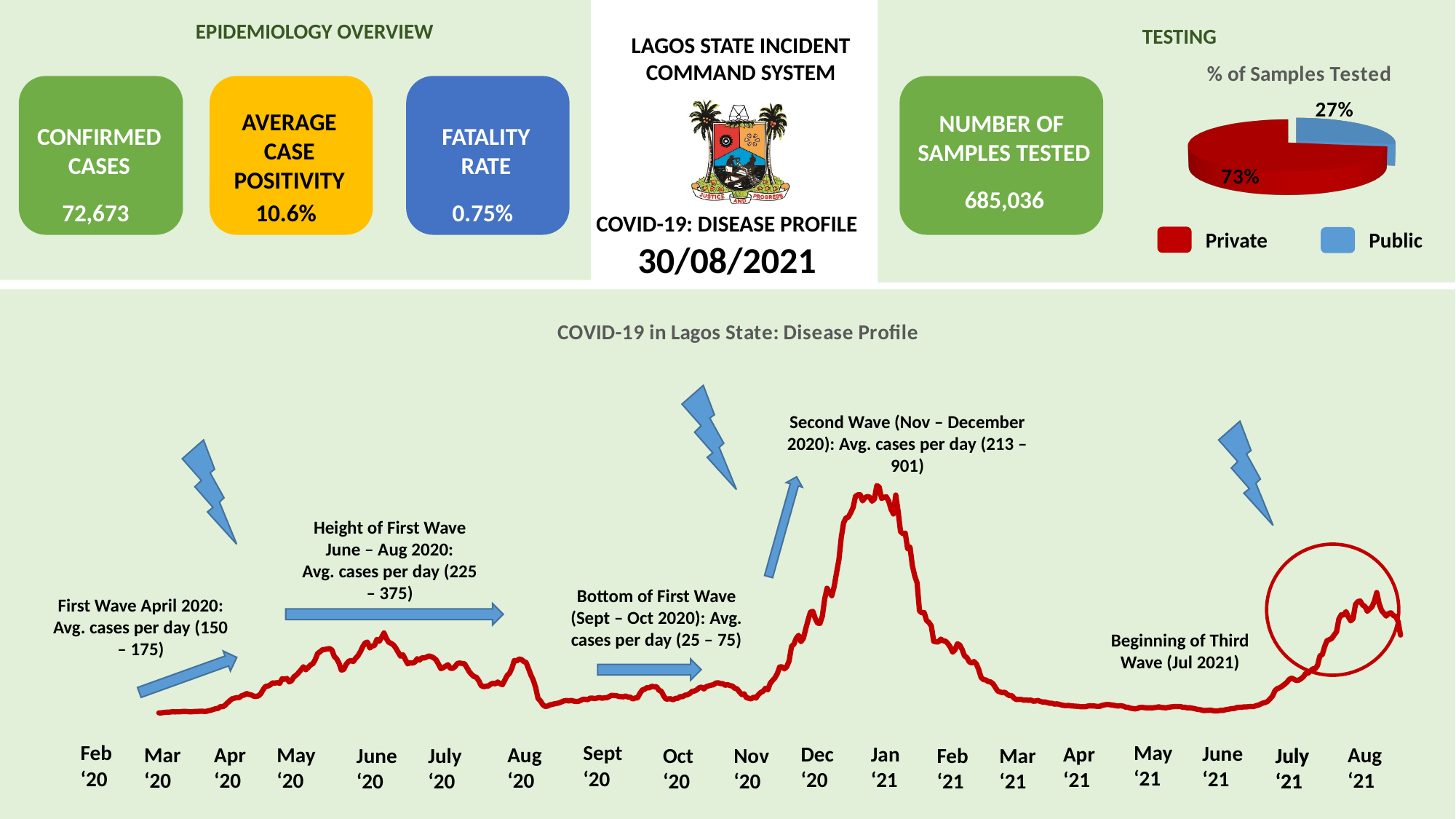
In the '% of Samples Tested' pie chart, what colour represents Public? Blue In the '% of Samples Tested' pie chart, what percentage of samples were tested by Private facilities? 73% In the 'COVID-19 in Lagos State: Disease Profile' chart, does the line rise or fall between Jan '21 and Mar '21? Fall What kind of chart is the '% of Samples Tested' chart? Pie chart In the '% of Samples Tested' pie chart, what percentage of samples were tested by Public facilities? 27% What kind of chart is 'COVID-19 in Lagos State: Disease Profile'? Line chart In the '% of Samples Tested' pie chart, which category has the larger share? Private In the '% of Samples Tested' pie chart, what is the difference in percentage points between the Private and Public shares? 46% In the 'COVID-19 in Lagos State: Disease Profile' chart, around which month label does the line reach its highest point? Jan '21 In the 'COVID-19 in Lagos State: Disease Profile' chart, what range of average cases per day is annotated for the Second Wave (Nov – December 2020)? 213 – 901 How many categories does the legend of the '% of Samples Tested' chart list? 2 How many month labels are shown on the x axis of the 'COVID-19 in Lagos State: Disease Profile' chart? 19